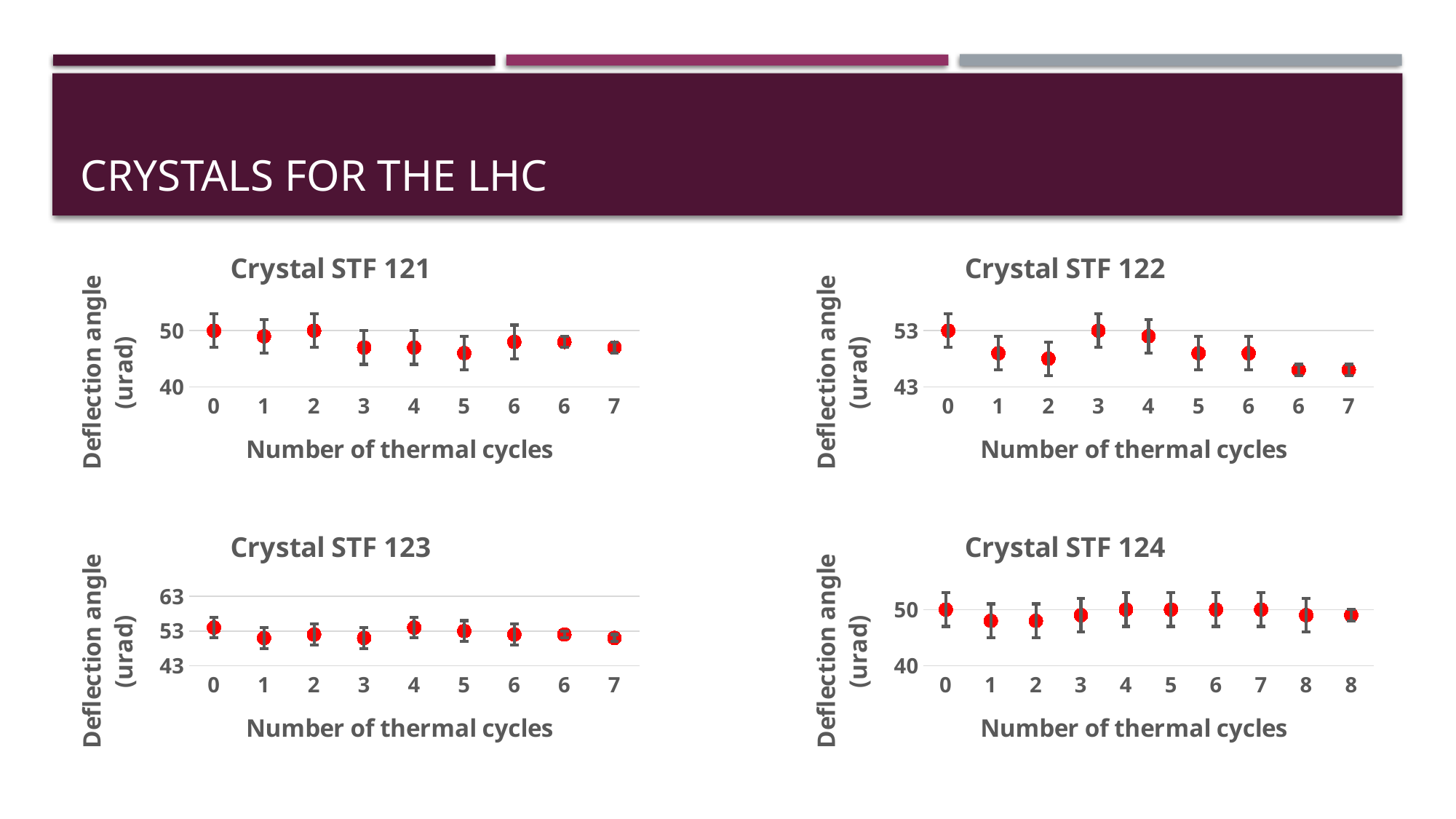
How many data points are plotted in the Crystal STF 124 chart? 10 What is the y-axis label of the Crystal STF 124 chart? Deflection angle (urad) In the Crystal STF 122 chart, do the deflection angle values generally rise or fall as the number of thermal cycles increases? fall In the Crystal STF 121 chart, is the value at 3 thermal cycles greater or less than 50? less In the Crystal STF 121 chart, do the deflection angle values generally rise or fall as the number of thermal cycles increases? fall What type of chart is the Crystal STF 121 chart? scatter chart In the Crystal STF 123 chart, is the value at 4 thermal cycles greater or less than 63? less How many data points are plotted in the Crystal STF 121 chart? 9 What is the x-axis label of the Crystal STF 123 chart? Number of thermal cycles In the Crystal STF 124 chart, is the value at 1 thermal cycle greater or less than 50? less